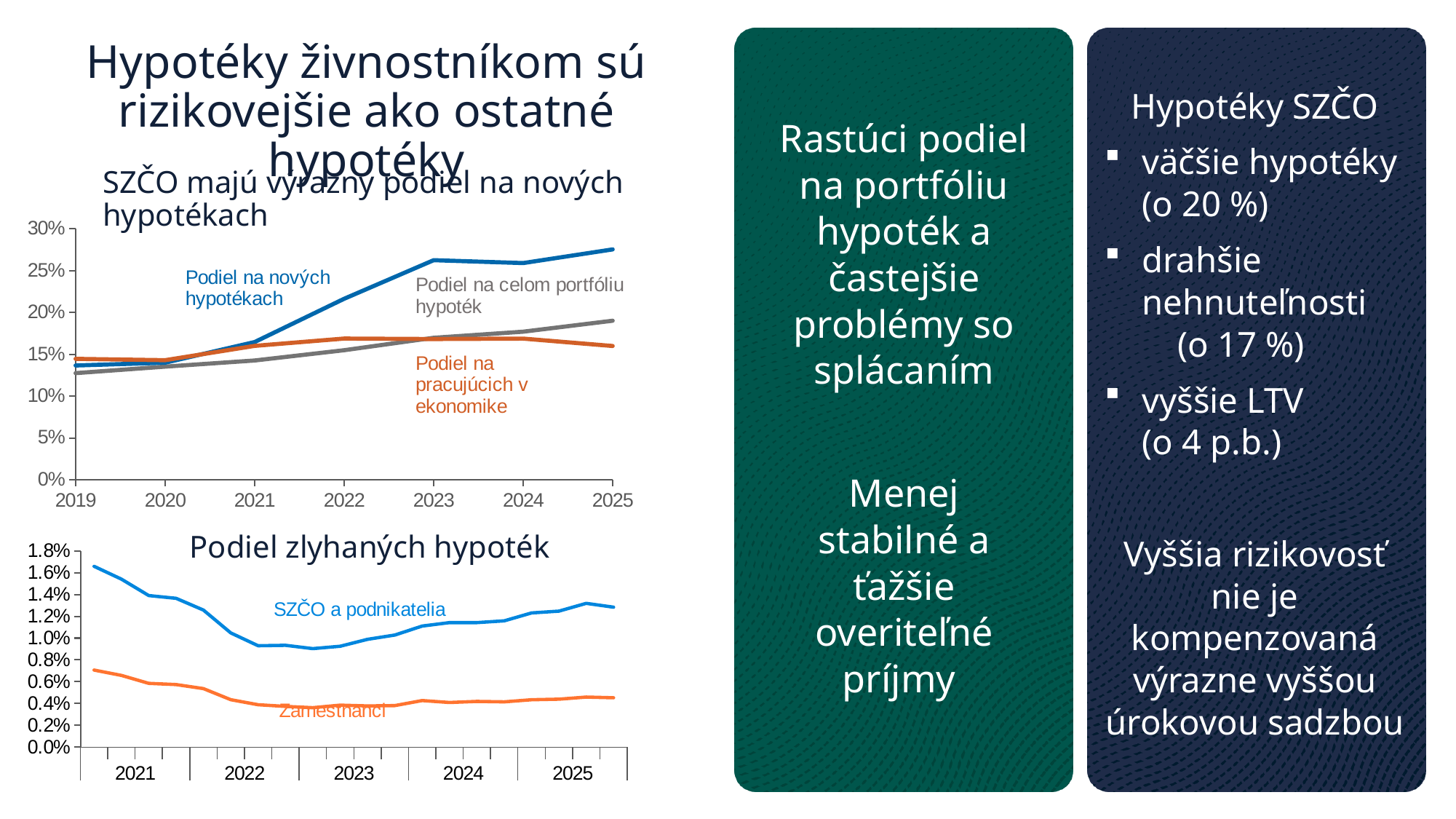
In the top chart 'SZČO majú výrazný podiel na nových hypotékach', which series is shown in orange? Podiel na pracujúcich v ekonomike In the top chart 'SZČO majú výrazný podiel na nových hypotékach', how many years are shown on the x axis? 7 In the top chart 'SZČO majú výrazný podiel na nových hypotékach', which is larger in 2025: 'Podiel na nových hypotékach' or 'Podiel na celom portfóliu hypoték'? Podiel na nových hypotékach In the bottom chart 'Podiel zlyhaných hypoték', is the value for 'SZČO a podnikatelia' at the start of 2021 greater or less than 1.4%? greater In the top chart 'SZČO majú výrazný podiel na nových hypotékach', is the value of 'Podiel na celom portfóliu hypoték' in 2025 greater or less than 20%? less In the top chart 'SZČO majú výrazný podiel na nových hypotékach', is the value of 'Podiel na nových hypotékach' in 2025 greater or less than 25%? greater In the top chart 'SZČO majú výrazný podiel na nových hypotékach', does the line 'Podiel na nových hypotékach' rise or fall from 2019 to 2025? rise What kind of chart is the bottom chart titled 'Podiel zlyhaných hypoték'? line chart In the bottom chart 'Podiel zlyhaných hypoték', which series has the higher values: 'SZČO a podnikatelia' or 'Zamestnanci'? SZČO a podnikatelia What kind of chart is the top chart titled 'SZČO majú výrazný podiel na nových hypotékach'? line chart